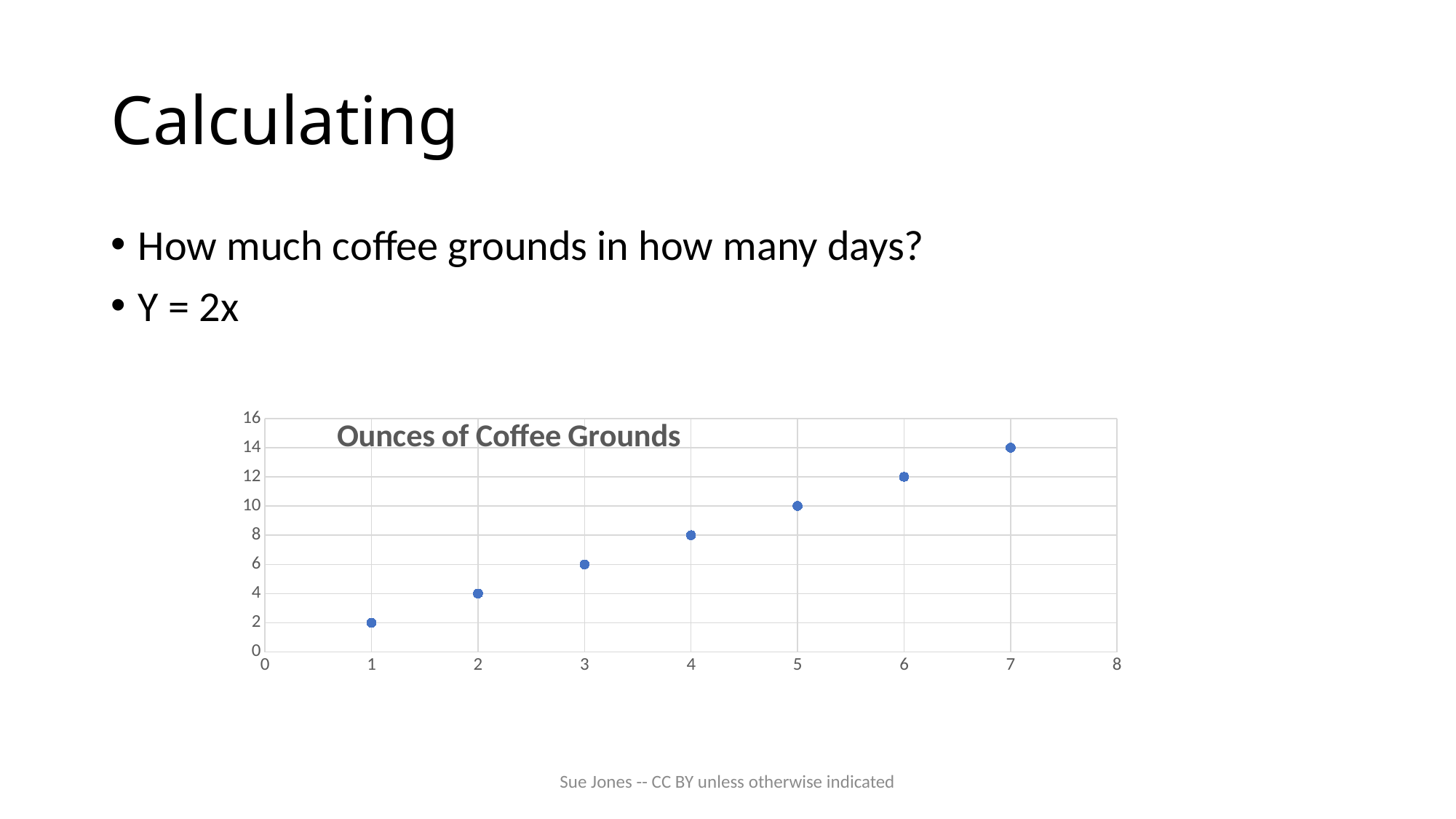
At which x value is the plotted y value lowest? 1 How many data points are plotted in the chart? 7 What is the y value of the point at x = 7? 14 What is the title of the chart? Ounces of Coffee Grounds What is the y value of the point at x = 1? 2 What is the difference between the y values at x = 6 and x = 2? 8 At which x value is the plotted y value highest? 7 What is the y value of the point at x = 4? 8 Which has the larger y value, the point at x = 3 or the point at x = 5? x = 5 What kind of chart is shown on the slide? scatter chart Is the y value at x = 6 greater or less than 10? greater Do the y values rise or fall as x increases? rise